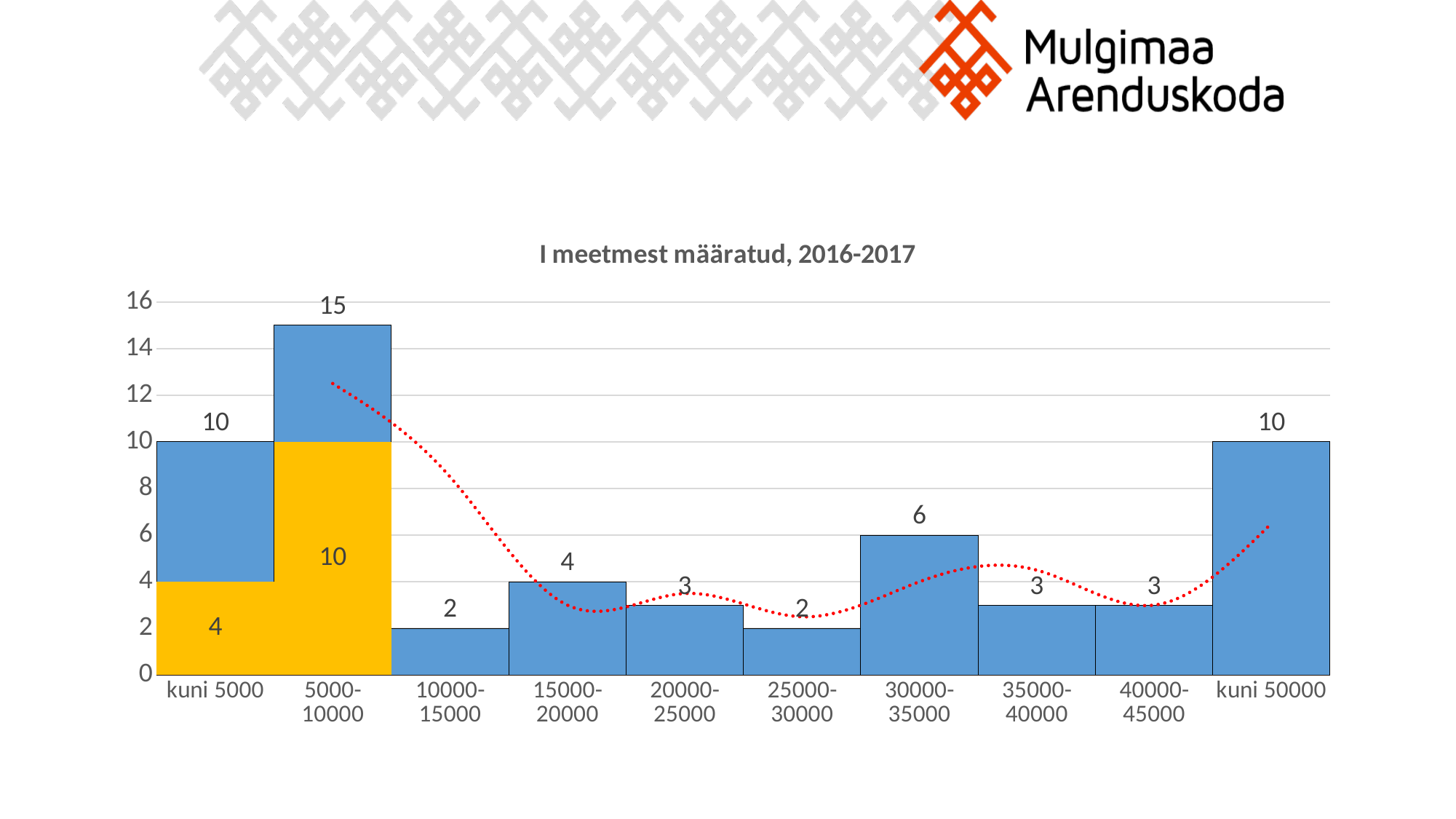
What value is labelled on the orange portion of the bar for kuni 5000? 4 What is the value of the blue bar for the category kuni 50000? 10 Which blue bar is larger, 15000-20000 or 30000-35000? 30000-35000 What is the value of the blue bar for the category 5000-10000? 15 What is the title of the chart? I meetmest määratud, 2016-2017 What is the value of the blue bar for the category 30000-35000? 6 How many categories are shown on the x axis of the chart? 10 What colour is the dotted trend line on the chart? red What is the difference between the blue bar values for 5000-10000 and kuni 5000? 5 What type of chart is shown on the slide? bar chart What value is labelled on the orange portion of the bar for 5000-10000? 10 Which category has the highest blue bar? 5000-10000